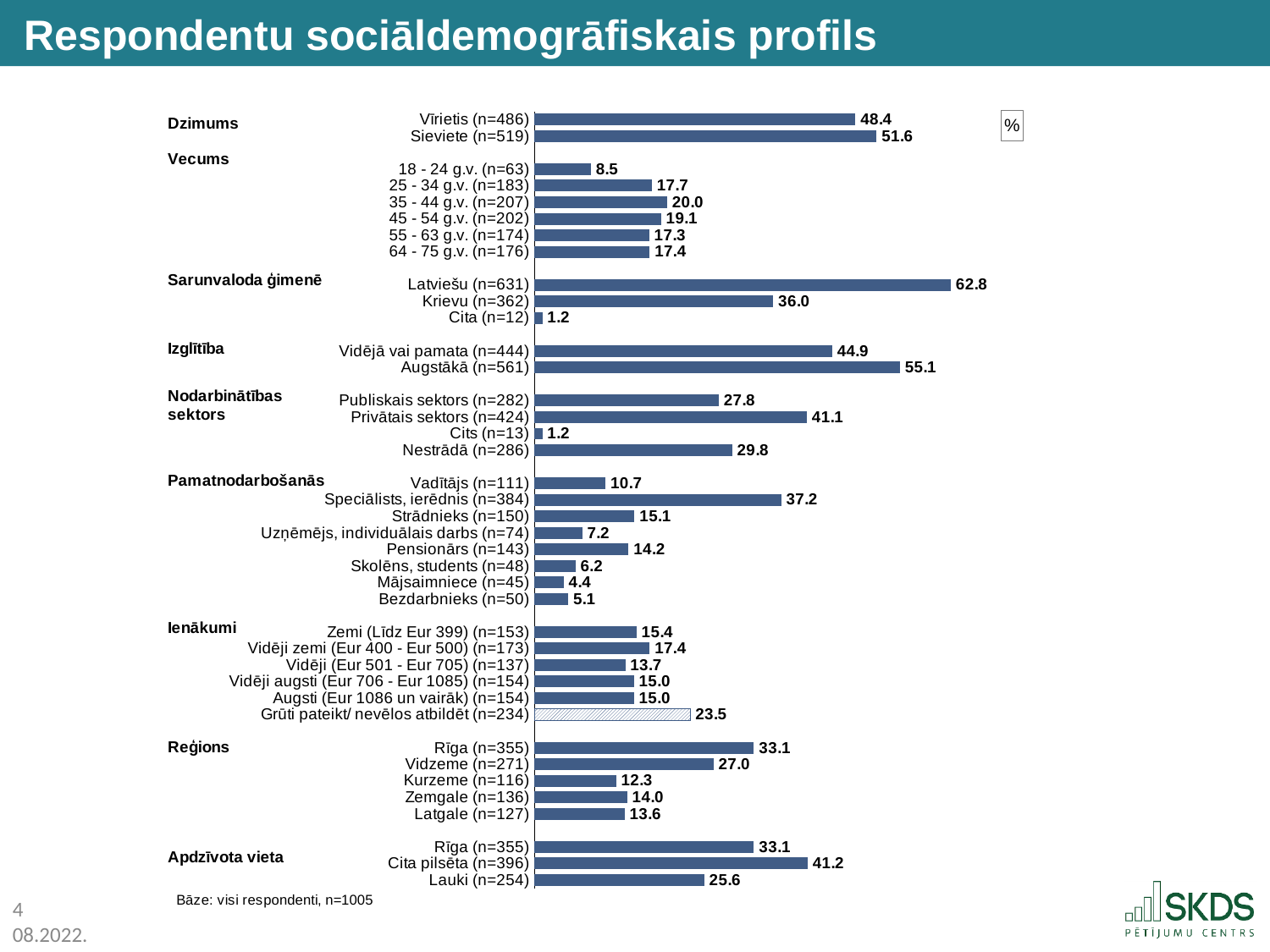
What is the value for Latviešu (n=631) under Sarunvaloda ģimenē? 62.8 What is the difference between the values for Augstākā (n=561) and Vidējā vai pamata (n=444)? 10.2 What kind of chart is shown on the slide? Bar chart What is the value for Privātais sektors (n=424)? 41.1 Which age group (Vecums) has the highest value? 35 - 44 g.v. (n=207) What is the total of the values for Rīga (n=355), Cita pilsēta (n=396) and Lauki (n=254) under Apdzīvota vieta? 99.9 What is the value for Grūti pateikt/ nevēlos atbildēt (n=234)? 23.5 What is the base (Bāze) stated below the chart? visi respondenti, n=1005 Which is larger, the value for Rīga (n=355) or Vidzeme (n=271) under Reģions? Rīga (n=355) Which category under Pamatnodarbošanās has the lowest value? Mājsaimniece (n=45) What is the value for Sieviete (n=519)? 51.6 How many categories are shown under Ienākumi? 6